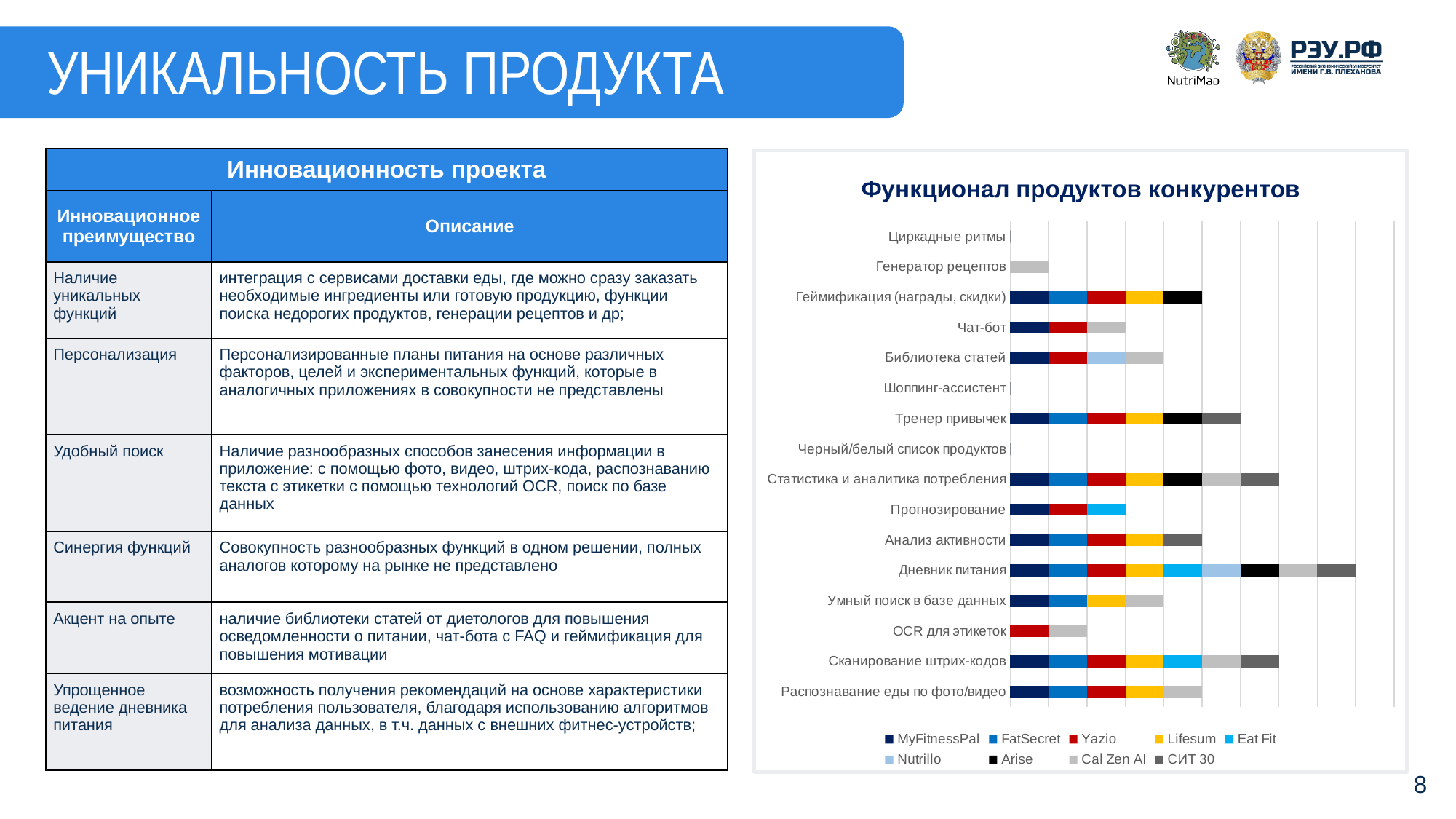
Which is larger in the chart: the bar for "Тренер привычек" or the bar for "Чат-бот"? Тренер привычек How many coloured segments make up the bar for "OCR для этикеток"? 2 Which feature category has the longest bar in the chart? Дневник питания Which is larger in the chart: the bar for "Сканирование штрих-кодов" or the bar for "Анализ активности"? Сканирование штрих-кодов What is the title of the chart on the right side of the slide? Функционал продуктов конкурентов Which series is shown in red in the chart legend? Yazio How many coloured segments make up the bar for "Дневник питания"? 9 How many series does the legend of the chart list? 9 How many feature categories are listed on the vertical axis of the chart? 16 Which is larger in the chart: the bar for "Дневник питания" or the bar for "Генератор рецептов"? Дневник питания What kind of chart is shown under the title "Функционал продуктов конкурентов"? Stacked bar chart